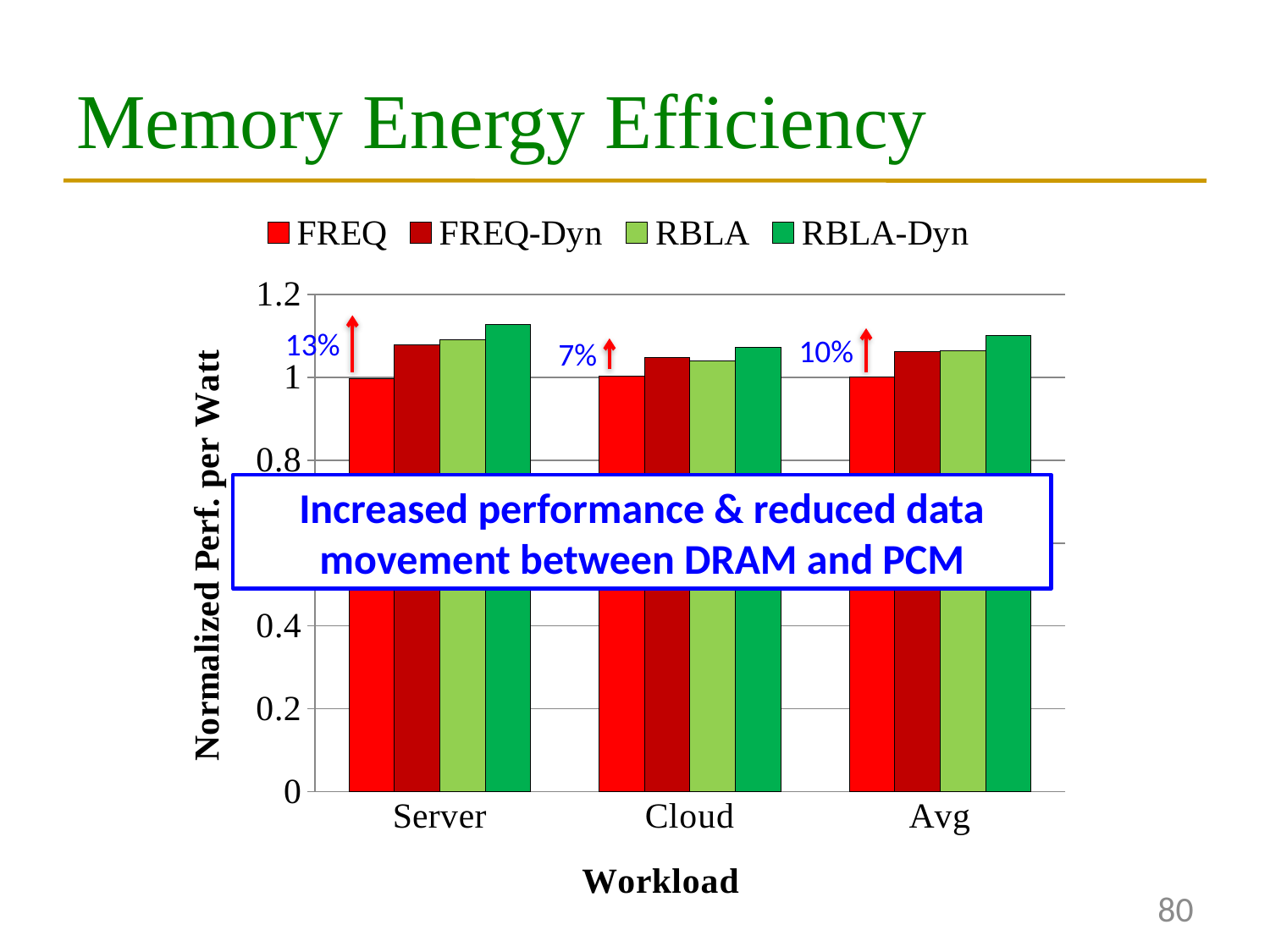
Which series has the lowest bar for the Avg workload? FREQ How many series does the legend list? 4 Is the value for RBLA-Dyn in the Server workload greater or less than 1? greater How many workload categories are shown on the x axis? 3 Which series has the highest bar for the Server workload? RBLA-Dyn Which series has the highest bar for the Cloud workload? RBLA-Dyn Is the value for RBLA-Dyn in the Avg workload greater or less than 1.2? less What kind of chart is shown on the slide? bar chart What is the title of the slide containing the chart? Memory Energy Efficiency What percentage improvement is annotated above the Server workload group? 13% Which is larger: the RBLA-Dyn bar for Server or the RBLA-Dyn bar for Cloud? Server